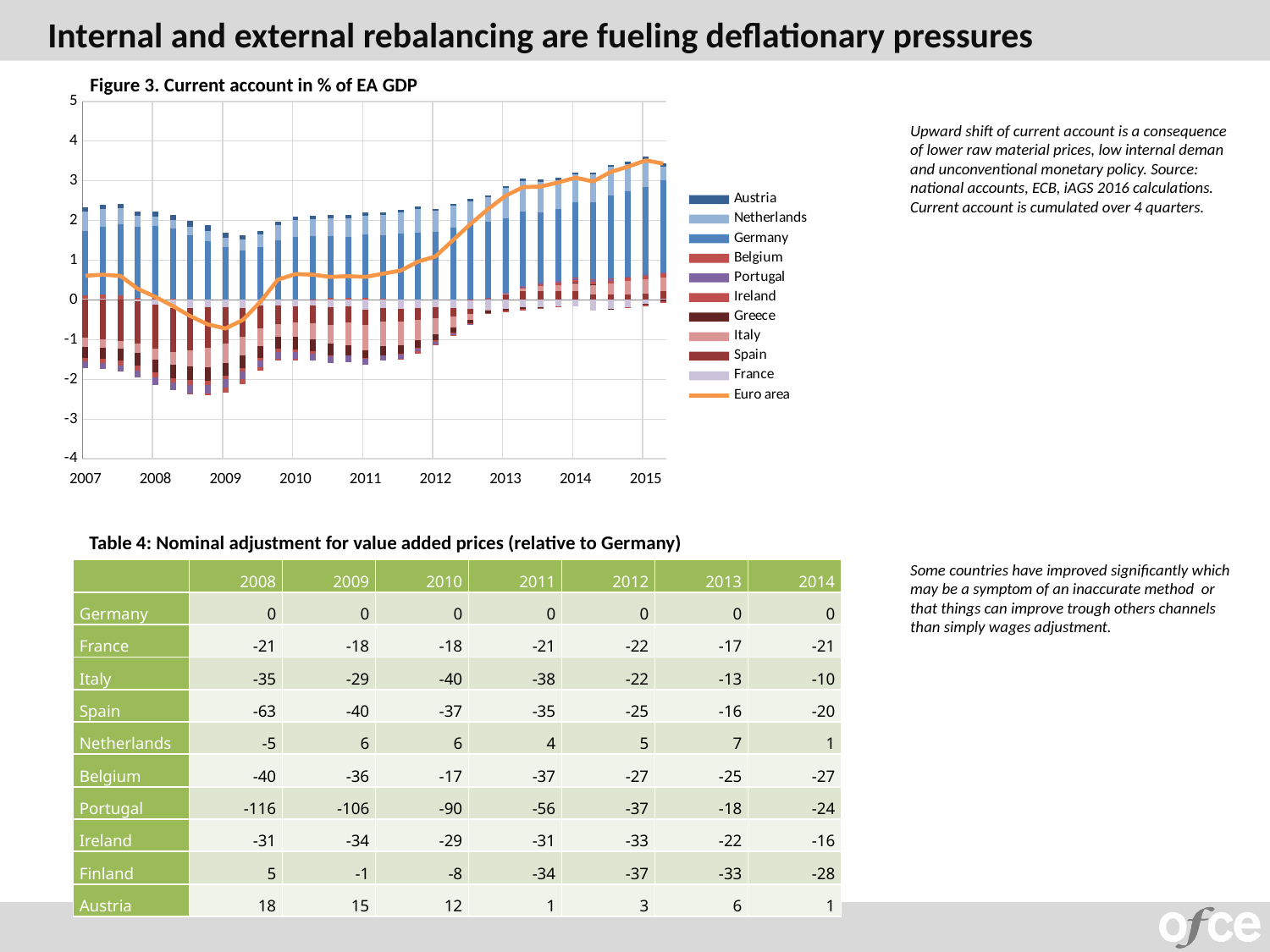
In Figure 3, does the Euro area line rise or fall between 2012 and 2015? rise In Figure 3, is the Euro area value in 2011 greater or less than 0? greater In Figure 3, does the Euro area line rise or fall between 2007 and 2009? fall How many entries does the legend of Figure 3 list? 11 In Figure 3, is the Euro area value in 2015 greater or less than 3? greater What is the title of the chart on the slide? Figure 3. Current account in % of EA GDP In Figure 3, is the Euro area value in 2009 greater or less than 0? less What kind of chart is Figure 3? Stacked bar chart with a line In Figure 3, which legend entry is shown as a line rather than bars? Euro area What is the first year shown on the x axis of Figure 3? 2007